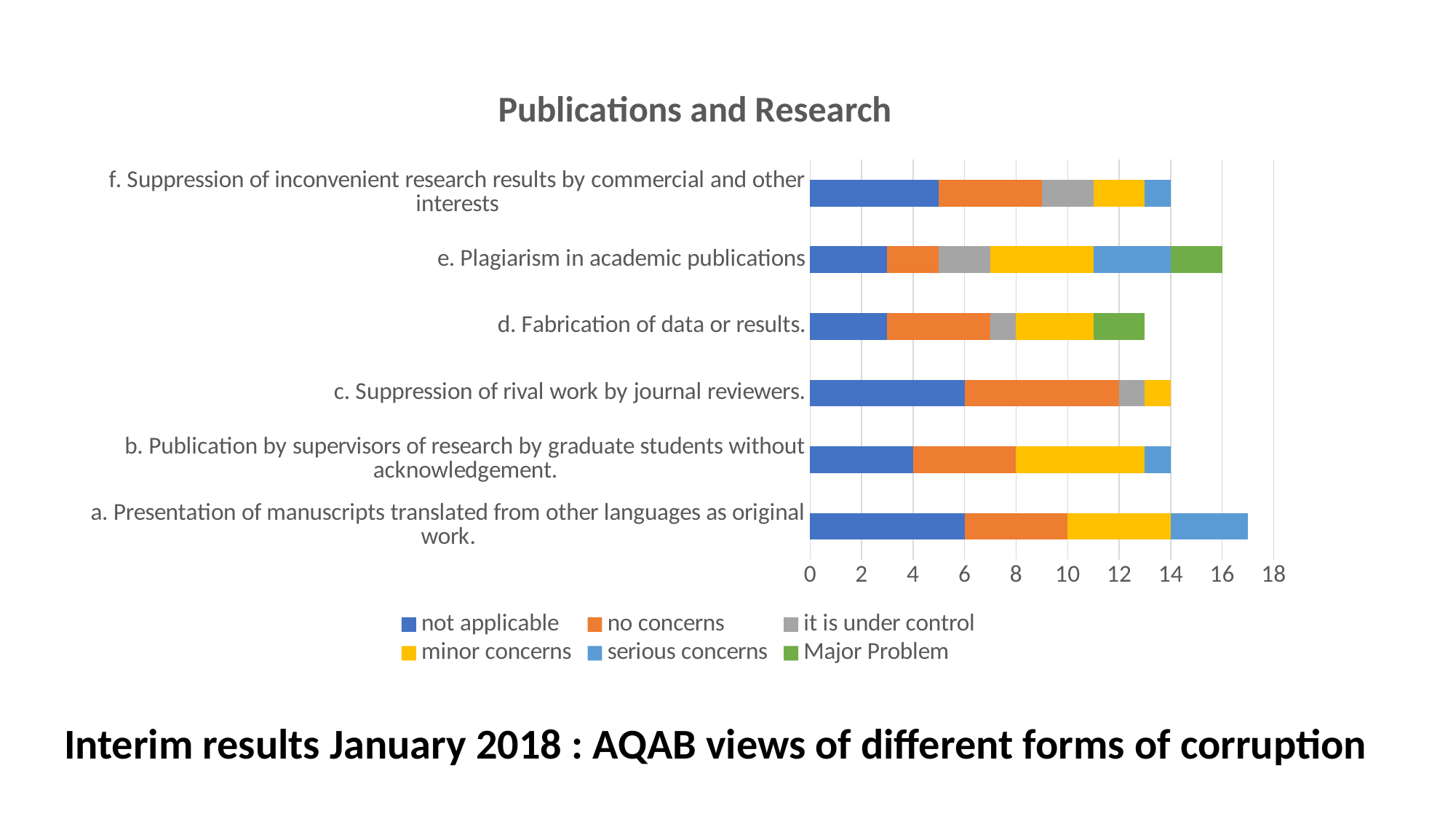
What is the 'not applicable' value for 'b. Publication by supervisors of research by graduate students without acknowledgement.'? 4 What is the total of the stacked bar for 'e. Plagiarism in academic publications'? 16 Is the total of the stacked bar for 'd. Fabrication of data or results.' greater or less than 14? less Which has the larger 'not applicable' value: 'a. Presentation of manuscripts translated from other languages as original work.' or 'e. Plagiarism in academic publications'? a. Presentation of manuscripts translated from other languages as original work. How many categories are plotted on the chart? 6 How many series does the legend list? 6 What kind of chart is shown on the slide? bar chart What is the total of the stacked bar for 'c. Suppression of rival work by journal reviewers.'? 14 Which colour represents the 'Major Problem' series in the legend? green What is the title of the chart? Publications and Research What is the 'not applicable' value for 'a. Presentation of manuscripts translated from other languages as original work.'? 6 Is the total of the stacked bar for 'a. Presentation of manuscripts translated from other languages as original work.' greater or less than 16? greater